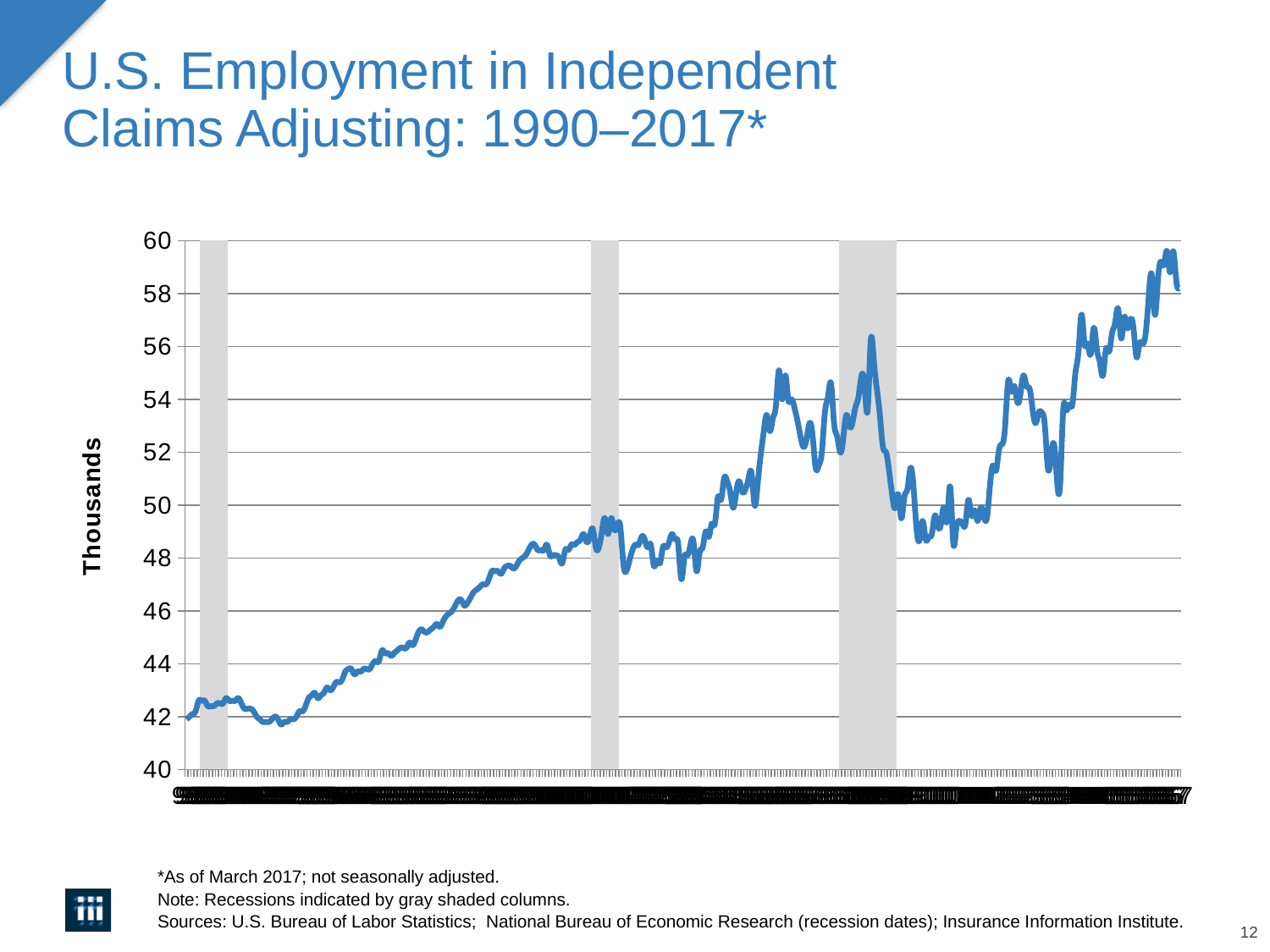
Is the highest point reached by the line greater or less than 58? greater Is the value at the end of the series (2017) greater or less than 56? greater What is the title of the chart on the slide? U.S. Employment in Independent Claims Adjusting: 1990–2017* What is the label on the vertical axis of the chart? Thousands Is the value at the end of the series (2017) greater or less than 60? less Which is larger, the value at the start of the series (1990) or the value at the end of the series (2017)? the value at the end (2017) Overall, do the values rise or fall from the start of the series in 1990 to the end in 2017? rise What kind of chart is shown on the slide? line chart What is the highest value shown on the vertical axis of the chart? 60